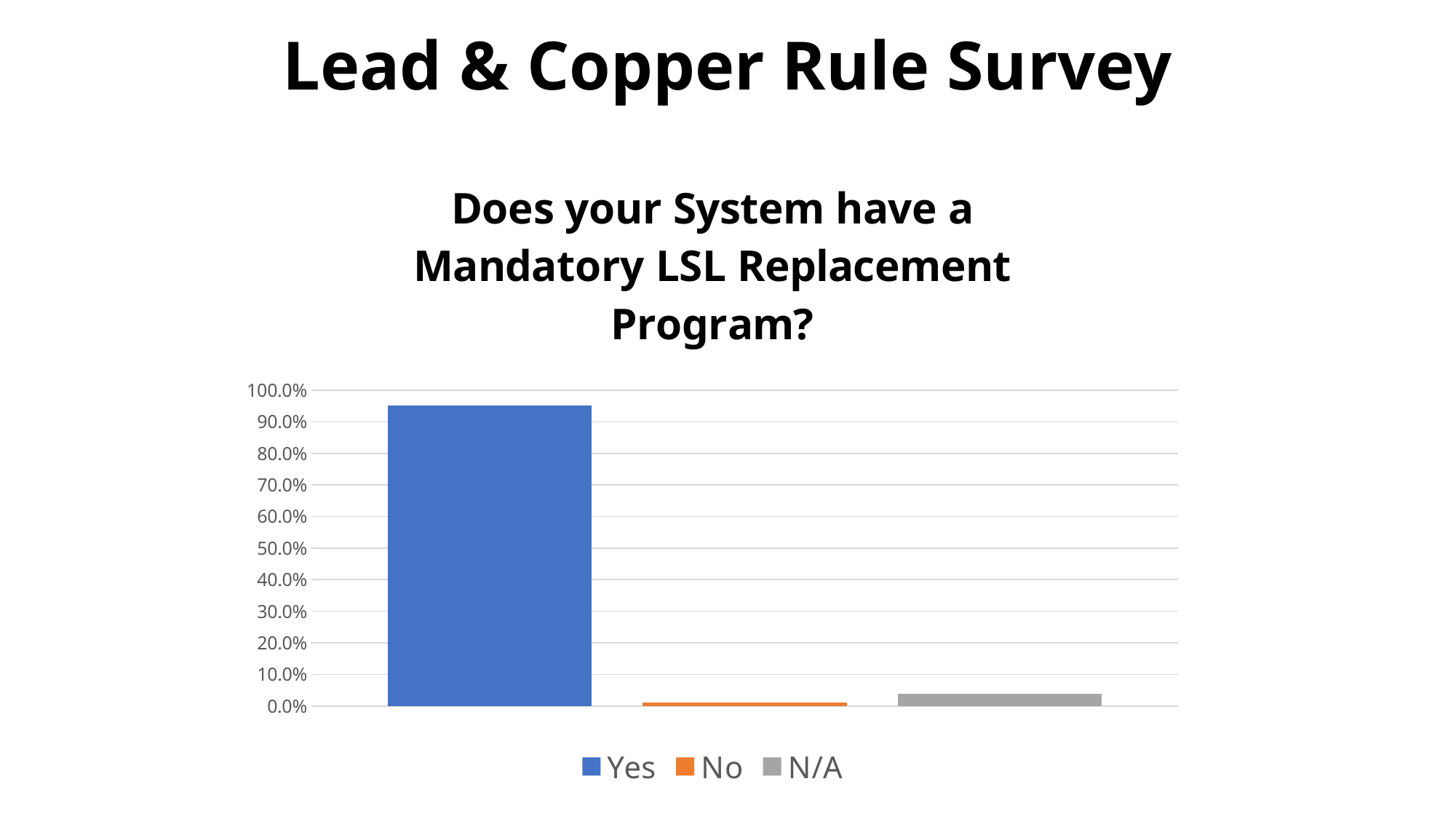
Which response has the lowest bar? No How many bars are plotted in the chart? 3 Is the value for Yes greater or less than 90.0%? greater Which is larger, the value for Yes or the value for N/A? Yes What is the title of the chart? Does your System have a Mandatory LSL Replacement Program? Which is larger, the value for N/A or the value for No? N/A Is the value for N/A greater or less than 10.0%? less Is the value for No greater or less than 10.0%? less How many entries does the legend list? 3 What colour is the bar for Yes? Blue What kind of chart is shown on the slide? Bar chart Which response has the highest bar? Yes